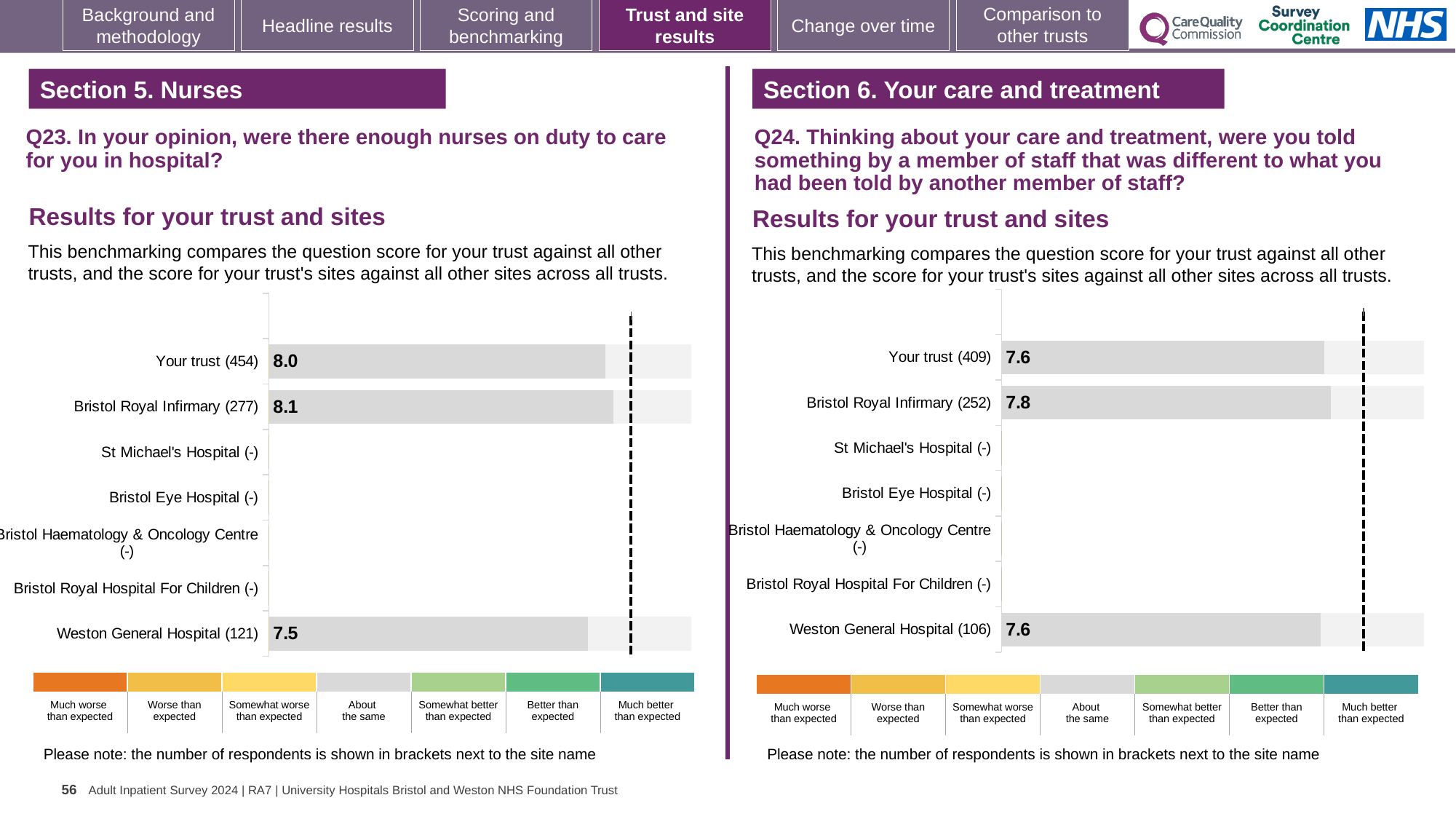
On the Q24 chart (right), what is the score for Your trust (409)? 7.6 On the Q23 chart (left), what is the score for Weston General Hospital (121)? 7.5 On the Q23 chart (left), which site with a plotted score has the lowest value? Weston General Hospital (121) On the Q24 chart (right), what is the score for Bristol Royal Infirmary (252)? 7.8 On the Q23 chart (left), what is the score for Bristol Royal Infirmary (277)? 8.1 On the Q23 chart (left), what is the score for Your trust (454)? 8.0 On the Q24 chart (right), what is the difference between the scores for Bristol Royal Infirmary (252) and Your trust (409)? 0.2 On the Q23 chart (left), what is the difference between the scores for Bristol Royal Infirmary (277) and Weston General Hospital (121)? 0.6 How many categories are listed on the Q23 chart (left)? 7 What kind of chart is the Q24 chart (right)? Bar chart On the Q24 chart (right), what is the score for Weston General Hospital (106)? 7.6 On the Q24 chart (right), which site with a plotted score has the highest value? Bristol Royal Infirmary (252)